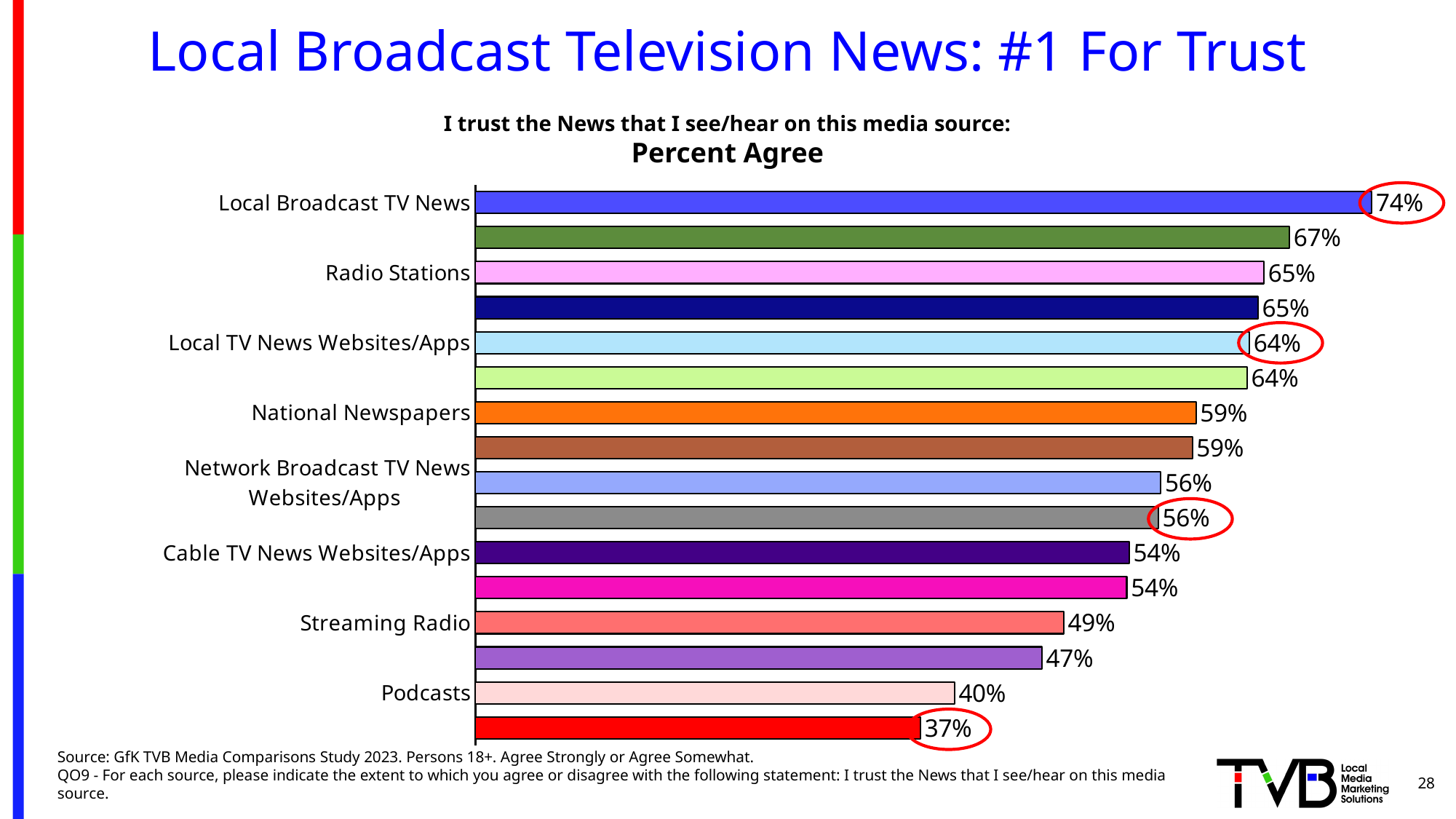
Which has a higher percent agree, Streaming Radio or Cable TV News Websites/Apps? Cable TV News Websites/Apps Do the values rise or fall going from the top bar to the bottom bar? Fall What percent agree that they trust the news on Local Broadcast TV News? 74% How many bars are plotted on the chart? 16 What is the percent agree value for Radio Stations? 65% Which media source has the highest percent agree for trust? Local Broadcast TV News What is the lowest percent agree value shown on the chart? 37% What is the percent agree value for Local TV News Websites/Apps? 64% What is the difference in percentage points between Local Broadcast TV News and Podcasts? 34 percentage points What is the percent agree value for National Newspapers? 59% What type of chart is shown on the slide? Bar chart What is the percent agree value for Podcasts? 40%